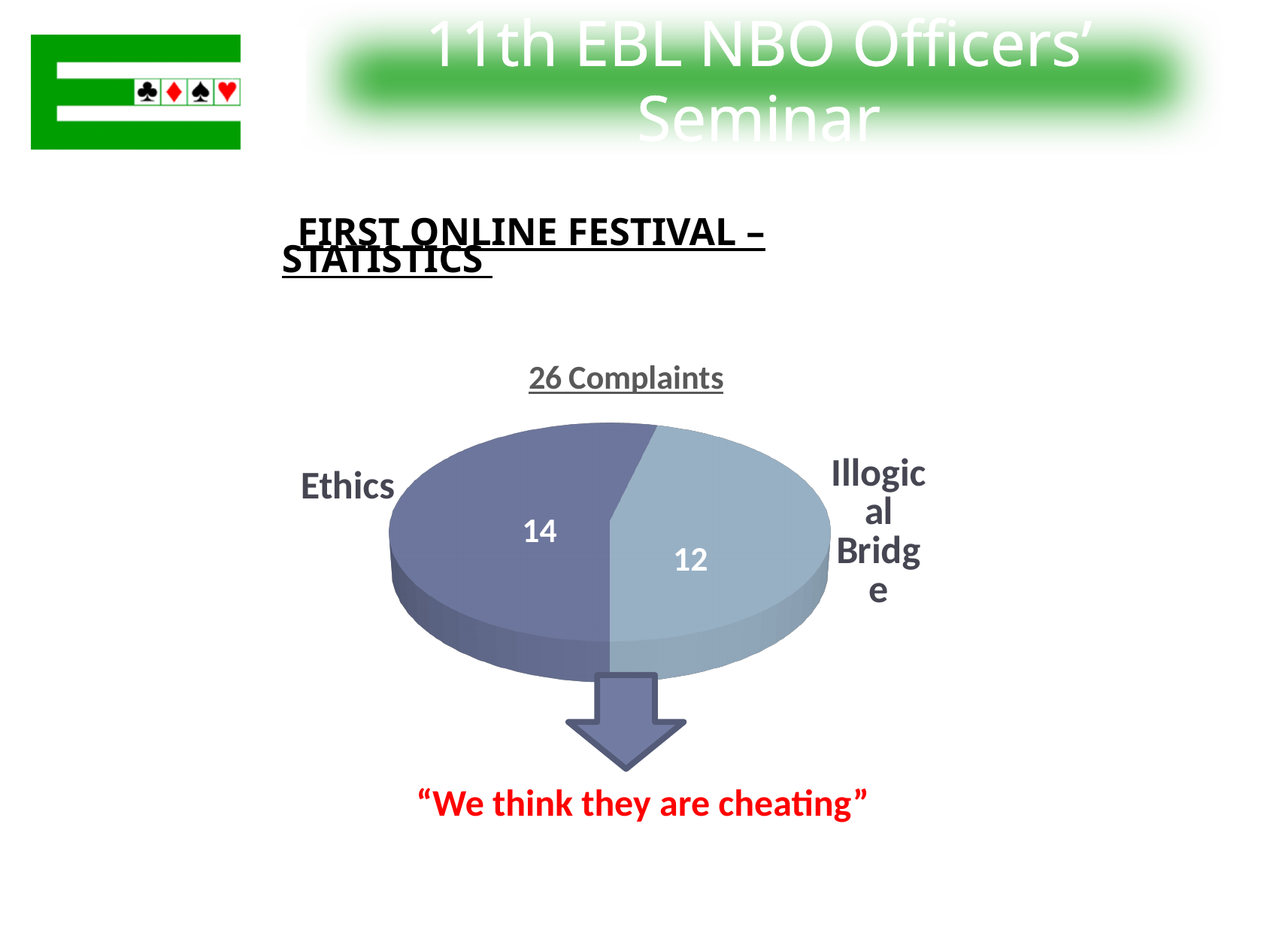
What type of chart is shown on the slide? Pie chart How many complaints are in the Illogical Bridge category? 12 What is the total number of complaints shown in the pie chart? 26 What text appears in red below the arrow under the chart? "We think they are cheating" Which category has the smaller number of complaints? Illogical Bridge Is the value for Ethics larger or smaller than the value for Illogical Bridge? Larger How many complaints are in the Ethics category? 14 What is the difference between the Ethics and Illogical Bridge complaint counts? 2 What is the title of the chart? 26 Complaints Which category has the larger number of complaints? Ethics How many categories does the pie chart show? 2